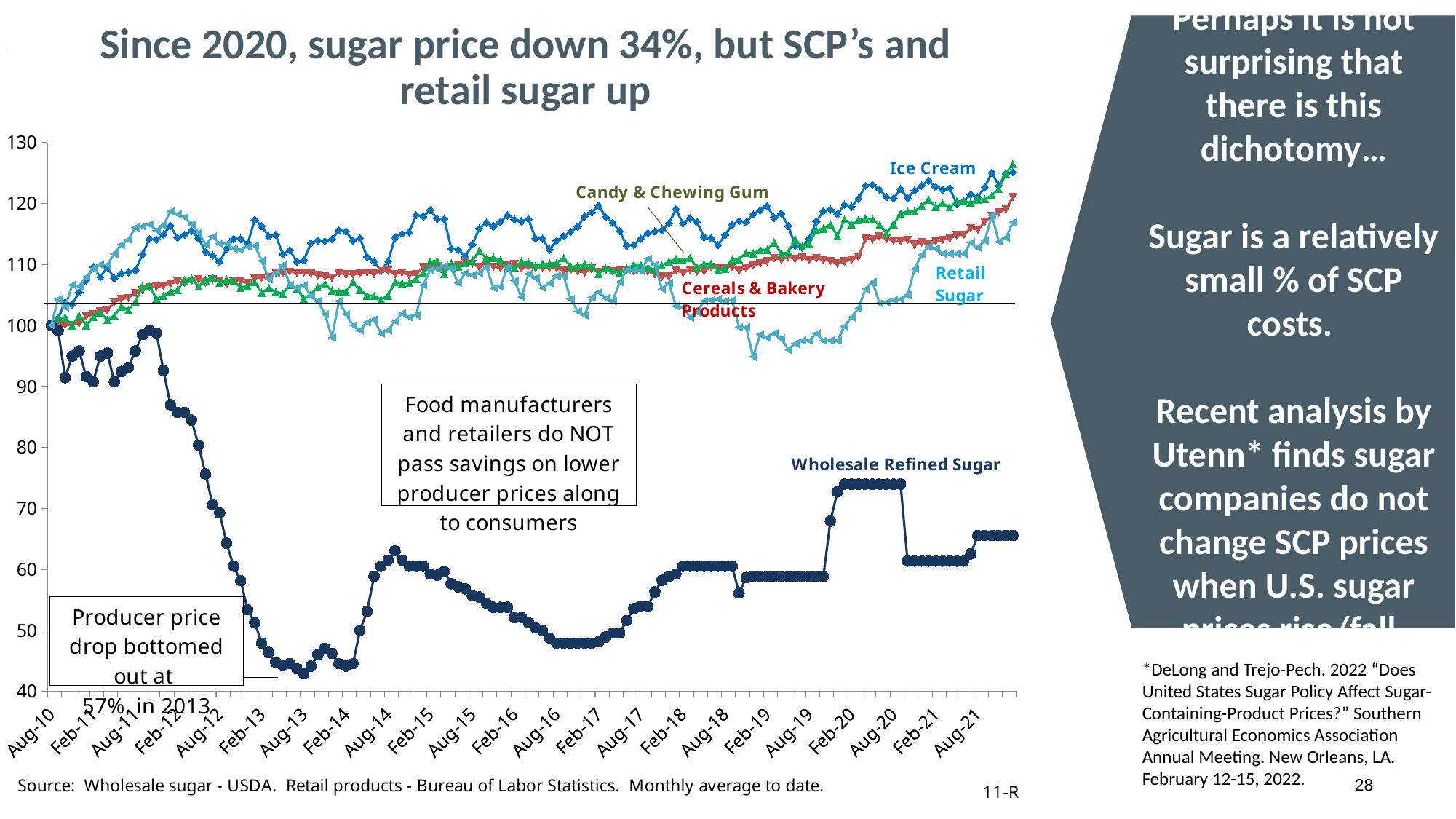
Is the value for Retail Sugar at Feb-19 greater or less than 100? less Does the Wholesale Refined Sugar series rise or fall between Aug-10 and Aug-13? fall How many data series are labelled on the chart? 5 What is the title of the chart on the slide? Since 2020, sugar price down 34%, but SCP's and retail sugar up Is the value for Wholesale Refined Sugar at Feb-20 greater or less than 70? greater At Aug-21, which is larger: Ice Cream or Wholesale Refined Sugar? Ice Cream Does the Ice Cream series rise or fall overall from Aug-10 to Aug-21? rise How many date labels are shown on the x axis? 23 Is the value for Wholesale Refined Sugar at Aug-13 greater or less than 50? less What kind of chart is shown on the slide? line chart Which series is lowest at Aug-21? Wholesale Refined Sugar